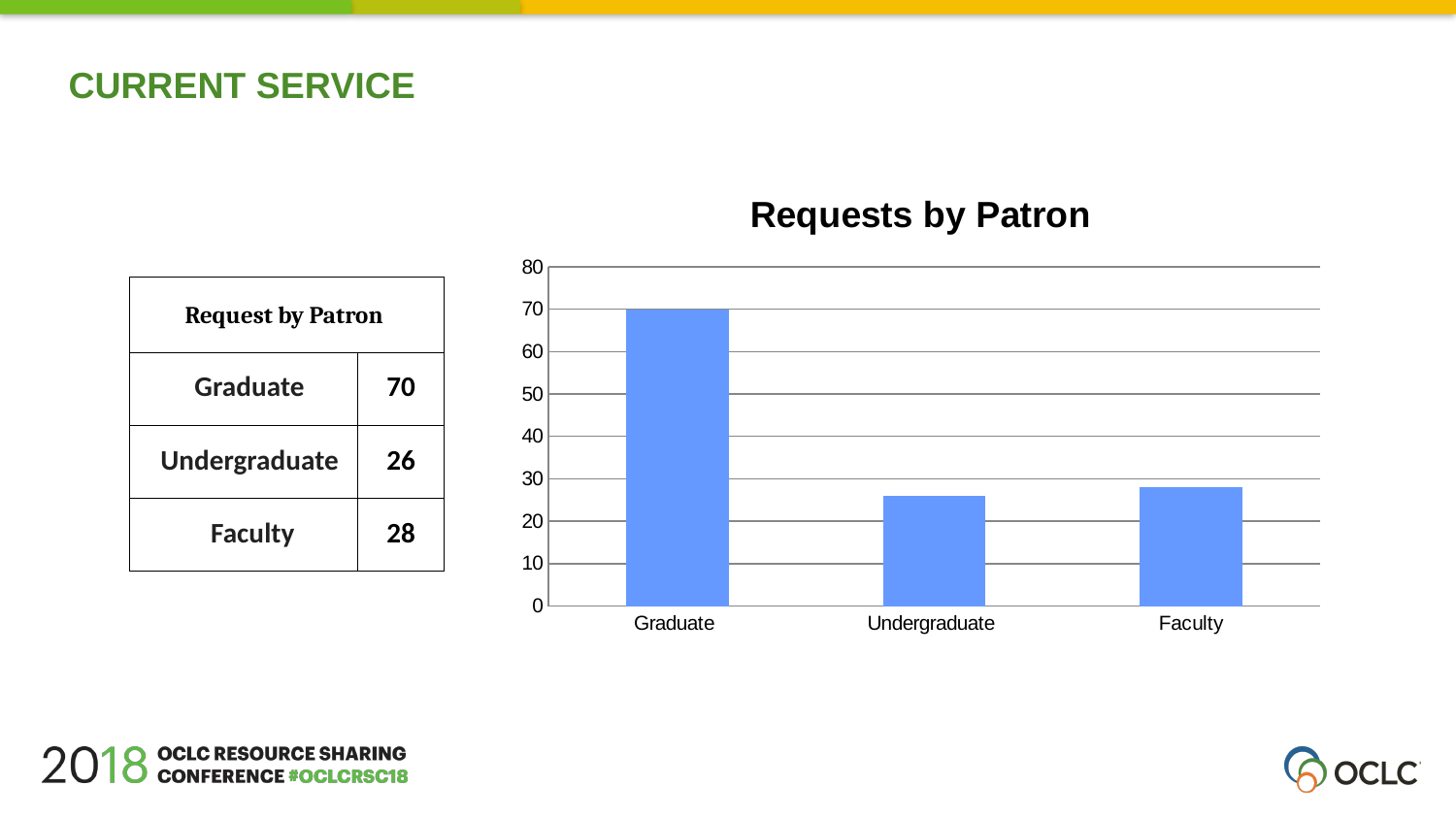
Which patron category has the lowest number of requests? Undergraduate Is the value for Undergraduate greater or less than 30? less What kind of chart is shown on the slide? bar chart What is the difference between the Graduate and Faculty values? 42 What is the value for Graduate in the Requests by Patron chart? 70 How many patron categories are shown in the chart? 3 What is the difference between the Faculty and Undergraduate values? 2 What is the value for Undergraduate in the Requests by Patron chart? 26 Which is larger, the value for Graduate or the value for Faculty? Graduate Which patron category has the highest number of requests? Graduate What is the value for Faculty in the Requests by Patron chart? 28 What is the title of the chart? Requests by Patron